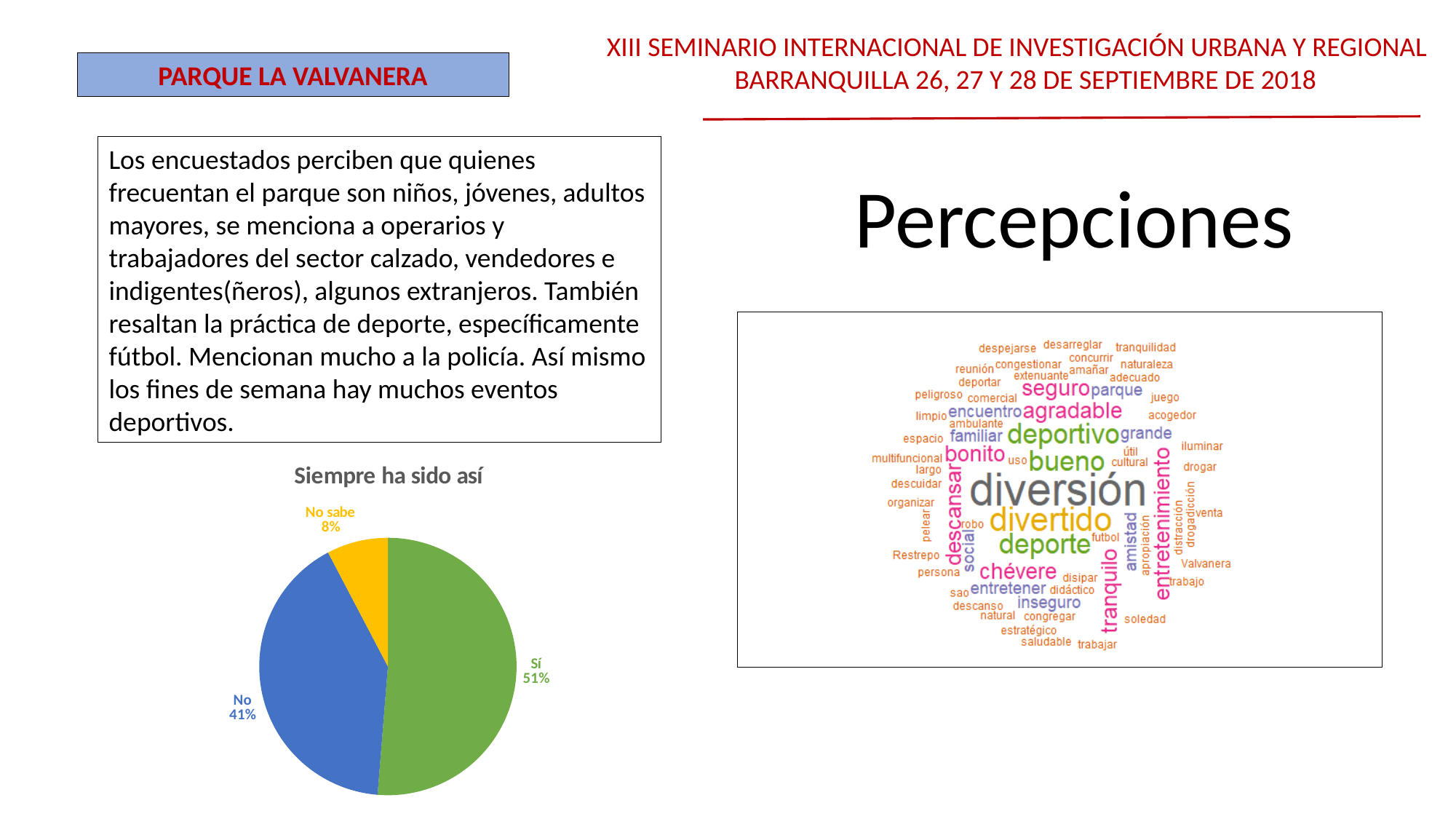
In the pie chart 'Siempre ha sido así', what is the difference between the shares of 'No' and 'No sabe'? 33% In the pie chart 'Siempre ha sido así', what is the difference between the shares of 'Sí' and 'No'? 10% In the pie chart 'Siempre ha sido así', what share does 'No sabe' have? 8% In the pie chart 'Siempre ha sido así', what share does 'No' have? 41% In the pie chart 'Siempre ha sido así', how many categories are shown? 3 In the pie chart 'Siempre ha sido así', what share does 'Sí' have? 51% In the pie chart 'Siempre ha sido así', which is larger, 'No' or 'No sabe'? No In the pie chart 'Siempre ha sido así', which category has the smallest share? No sabe In the pie chart 'Siempre ha sido así', what colour is the 'Sí' slice? green What is the title of the pie chart? Siempre ha sido así What type of chart is 'Siempre ha sido así'? pie chart In the pie chart 'Siempre ha sido así', which category has the largest share? Sí